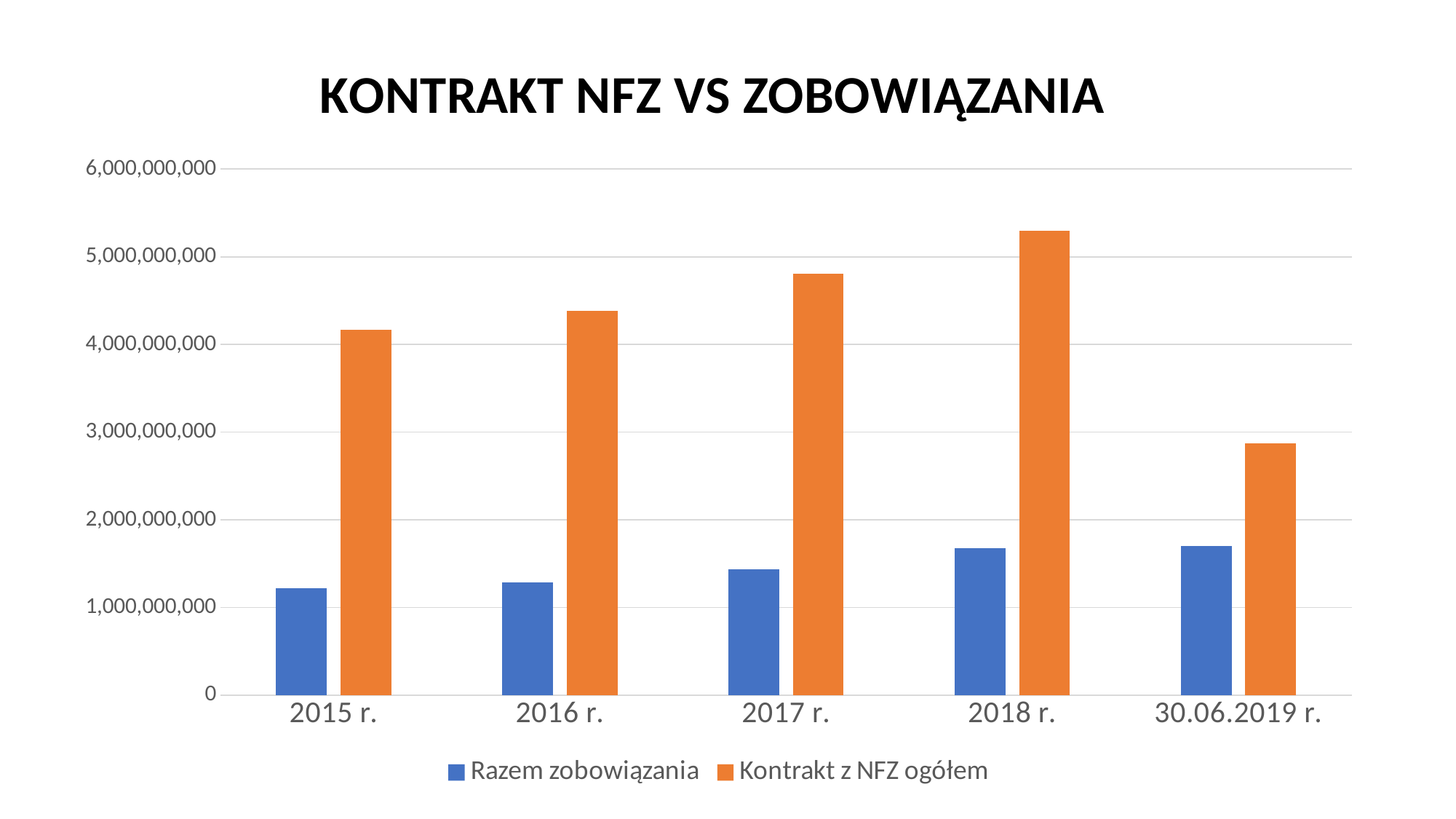
How many series does the legend list? 2 Which category has the highest value for Kontrakt z NFZ ogółem? 2018 r. How many categories are shown on the x axis? 5 What type of chart is shown on the slide? Bar chart Which is larger in 2017 r.: Razem zobowiązania or Kontrakt z NFZ ogółem? Kontrakt z NFZ ogółem Which category has the lowest value for Razem zobowiązania? 2015 r. What is the title of the chart? KONTRAKT NFZ VS ZOBOWIĄZANIA Do the values for Razem zobowiązania rise or fall from 2015 r. to 30.06.2019 r.? Rise Is the value for Kontrakt z NFZ ogółem in 2018 r. greater or less than 5,000,000,000? greater Which category has the lowest value for Kontrakt z NFZ ogółem? 30.06.2019 r. Is the value for Kontrakt z NFZ ogółem in 30.06.2019 r. greater or less than 3,000,000,000? less Is the value for Razem zobowiązania in 2018 r. greater or less than 2,000,000,000? less